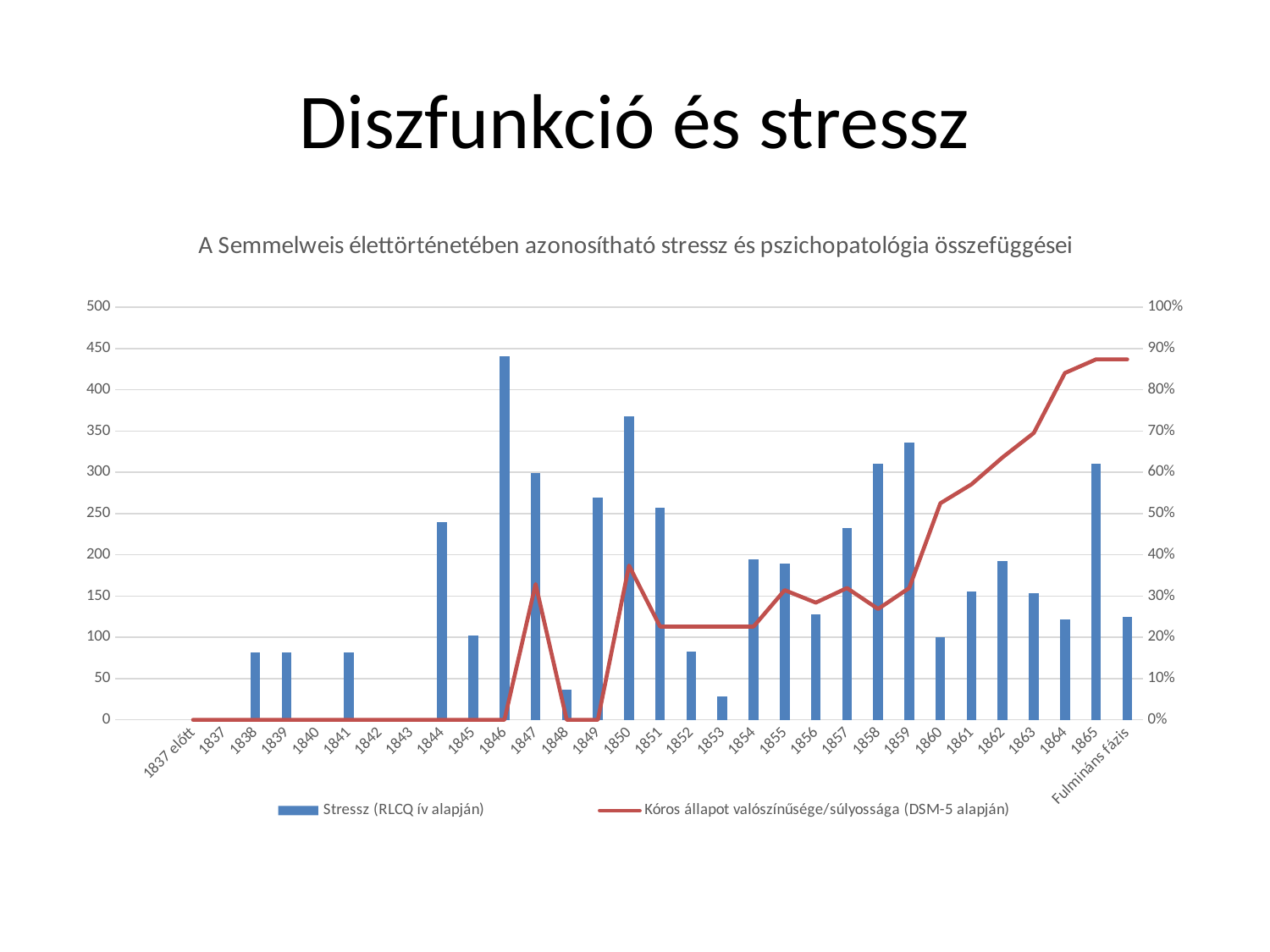
What kind of chart is this? A combined bar and line chart How many categories are shown on the x axis? 31 Does the Kóros állapot valószínűsége/súlyossága (DSM-5 alapján) line rise or fall from 1859 to Fulmináns fázis? rise Is the Kóros állapot valószínűsége/súlyossága (DSM-5 alapján) value for 1851 greater or less than 30%? less Is the Kóros állapot valószínűsége/súlyossága (DSM-5 alapján) value for Fulmináns fázis greater or less than 80%? greater Is the Stressz (RLCQ ív alapján) value for 1846 greater or less than 400? greater How many series does the legend list? 2 Which has the larger Stressz (RLCQ ív alapján) bar, 1846 or 1850? 1846 Which year has the highest bar for Stressz (RLCQ ív alapján)? 1846 What is the title of the chart? A Semmelweis élettörténetében azonosítható stressz és pszichopatológia összefüggései Which has the larger Stressz (RLCQ ív alapján) bar, 1847 or 1851? 1847